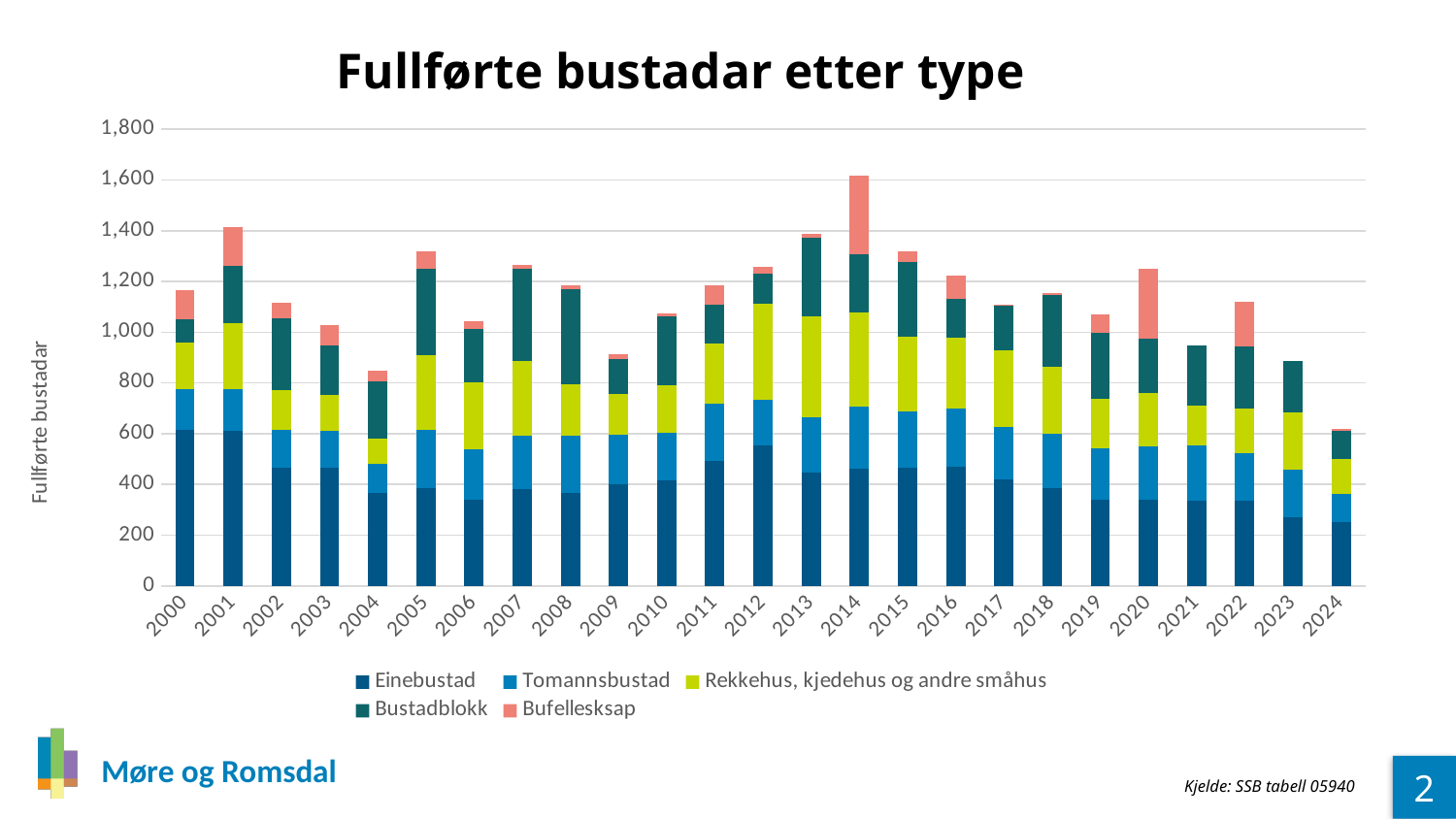
What kind of chart is shown on the slide? Stacked bar chart What is the title of the chart? Fullførte bustadar etter type Which year has a larger total bar, 2020 or 2021? 2020 Which year has the lowest total of completed dwellings? 2024 Which year has a larger total bar, 2012 or 2013? 2013 Is the total value for 2024 greater or less than 800? less How many years are shown along the x axis of the chart? 25 Which year has the highest total of completed dwellings? 2014 Is the total value for 2014 greater or less than 1,400? greater Is the total value for 2004 greater or less than 1,000? less Do the total bar heights rise or fall from 2020 to 2024? fall How many series does the legend list? 5